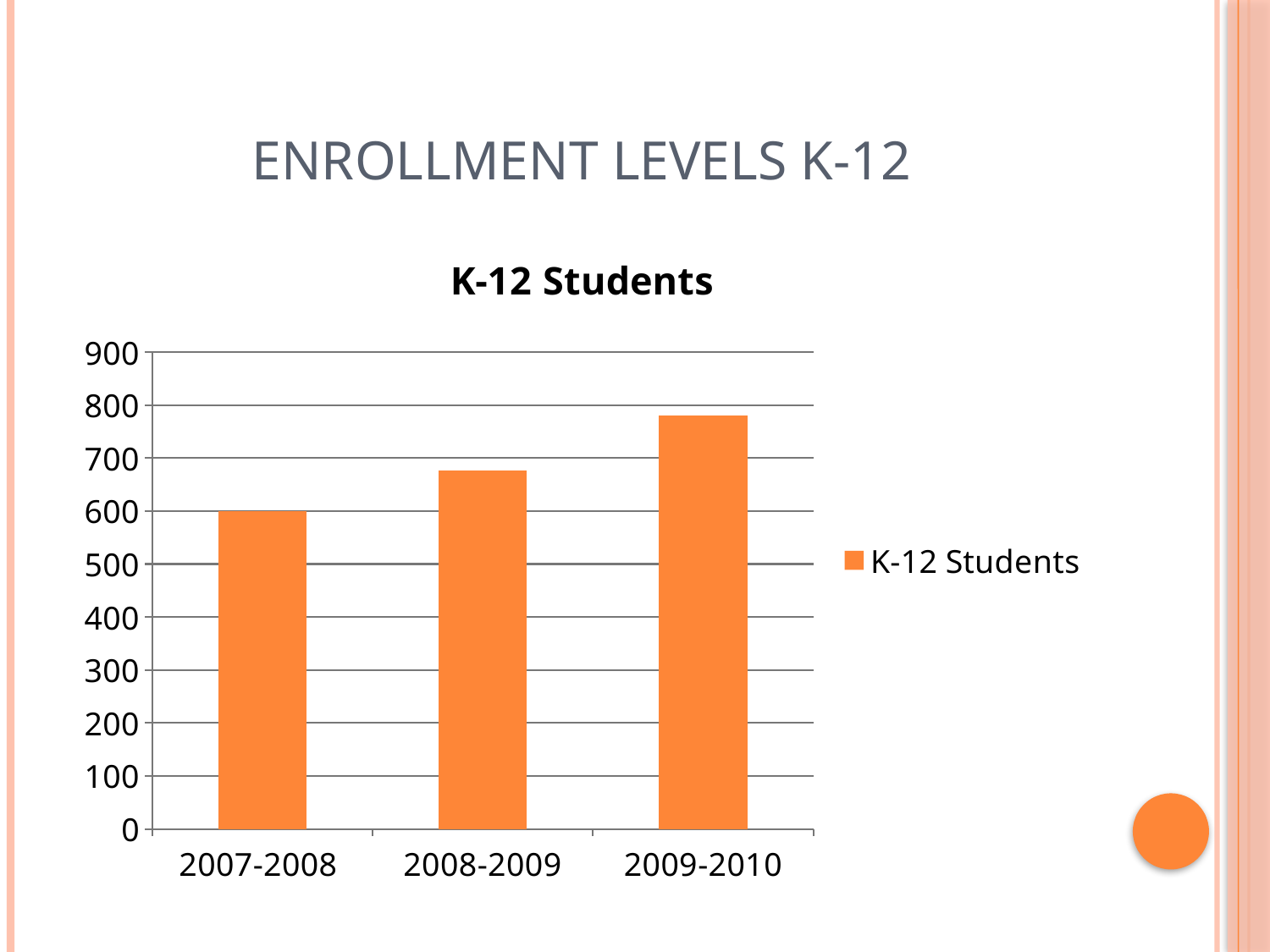
What is the title of the chart on the slide? K-12 Students Do the K-12 student numbers rise or fall from 2007-2008 to 2009-2010? rise Is the value for 2008-2009 greater or less than 600? greater Which school year has the lowest number of K-12 students? 2007-2008 What kind of chart is shown on the slide? bar chart How many series does the legend of the K-12 Students chart list? 1 Which school year has more K-12 students, 2008-2009 or 2009-2010? 2009-2010 Which school year has the highest number of K-12 students? 2009-2010 Is the value for 2008-2009 greater or less than 700? less What is the value for 2007-2008 in the K-12 Students chart? 600 Is the value for 2009-2010 greater or less than 800? less How many school years are shown on the x axis of the K-12 Students chart? 3